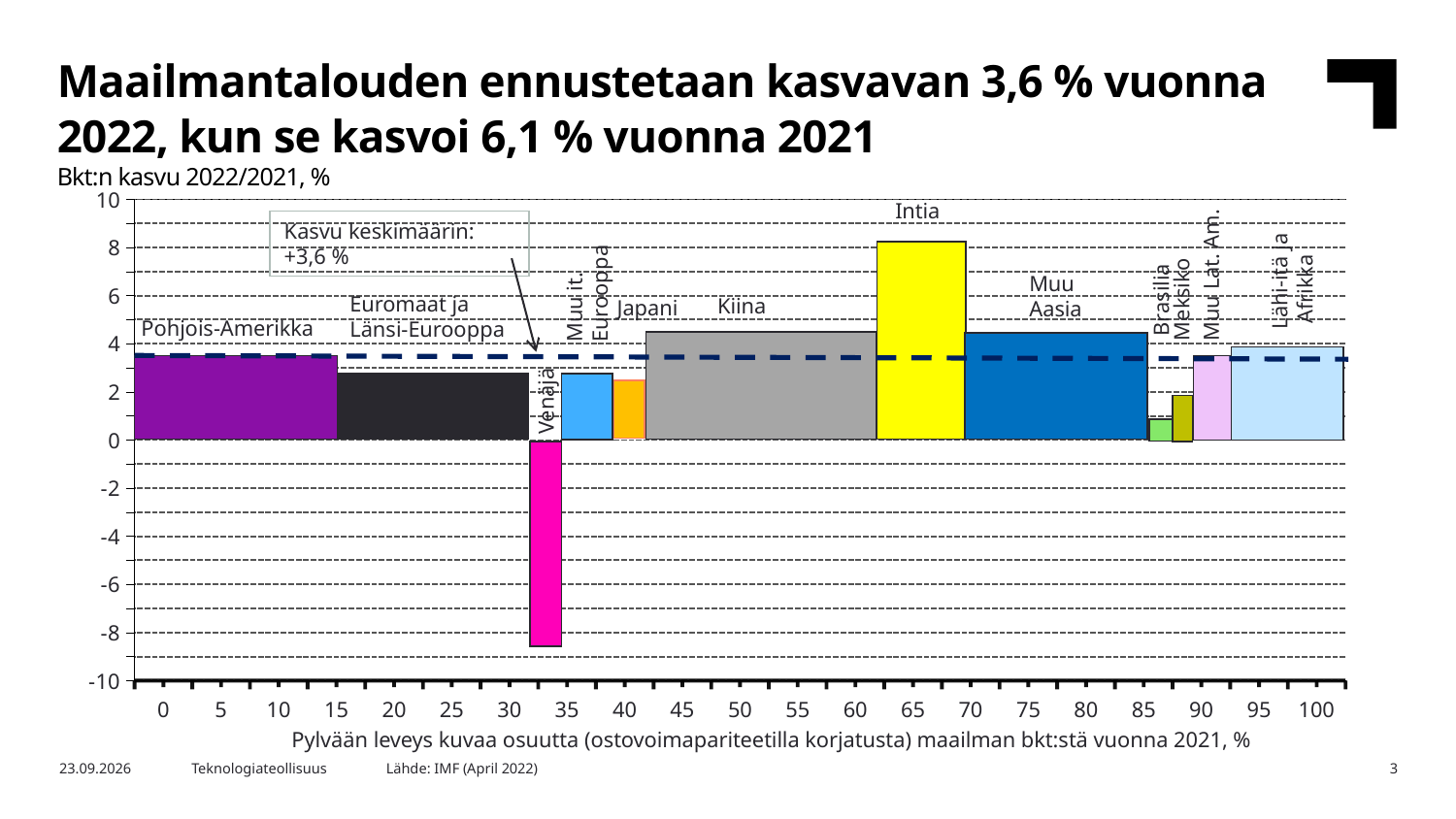
How many regions are shown as bars in the chart? 12 Is the value for Intia greater or less than 6? greater What kind of chart is shown on the slide? bar chart What average growth does the dashed line annotation in the chart indicate? +3,6 % Is the value for Japani greater or less than 4? less Is the value for Brasilia greater or less than 2? less Which has the larger value, Meksiko or Brasilia? Meksiko Which has the larger value, Intia or Kiina? Intia Which region has the highest GDP growth in the chart? Intia Which region has the lowest GDP growth in the chart? Venäjä